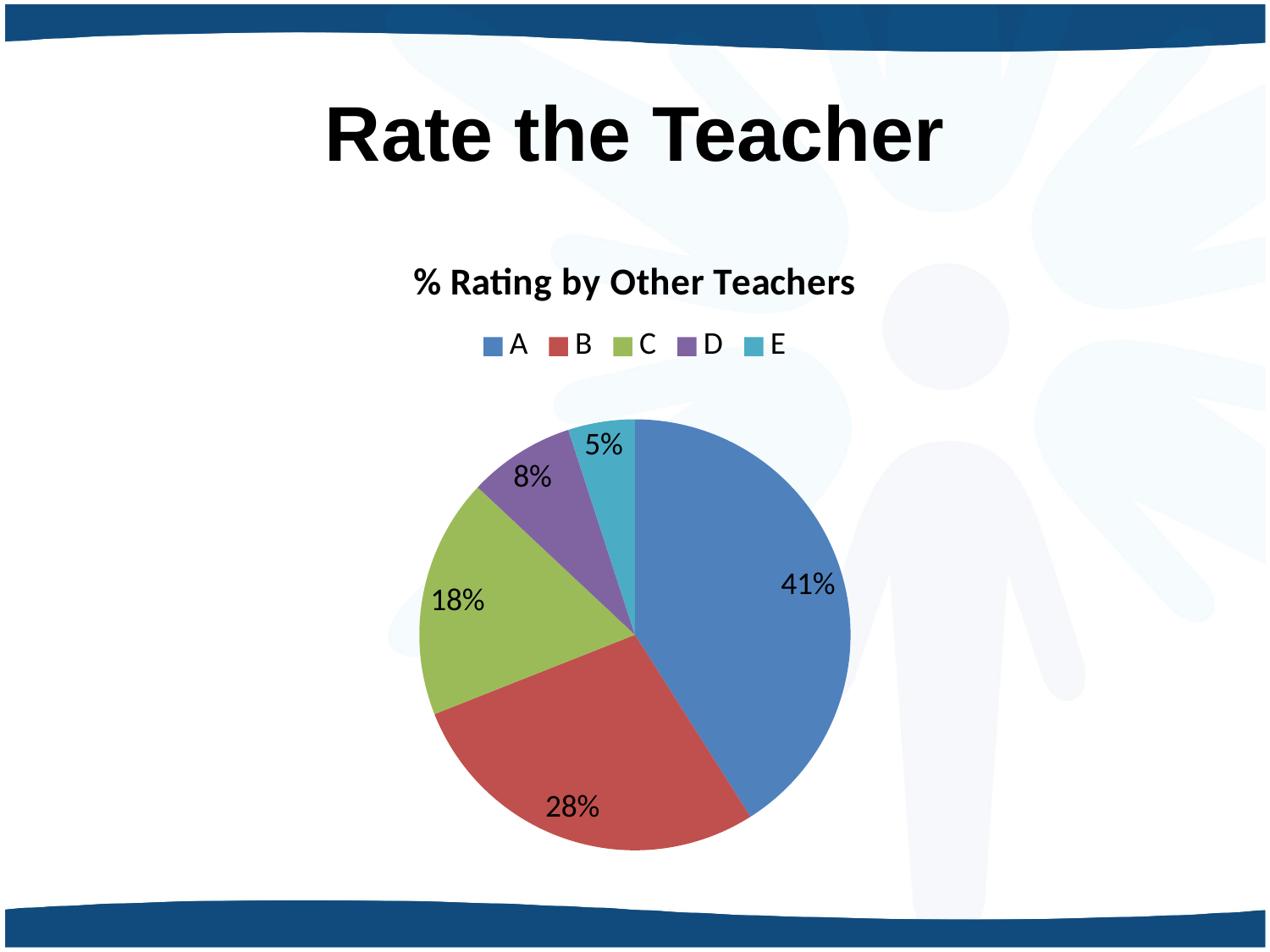
What percentage of the pie is rating D? 8% Which rating has the largest share of the pie? A What type of chart is shown on the slide? pie chart Which rating has the smallest share of the pie? E What is the difference in percentage points between rating A and rating B? 13 What percentage of the pie is rating C? 18% Which is larger, the share for rating C or the share for rating D? C How many slices does the pie chart have? 5 What percentage of the pie is rating E? 5% What percentage of the pie is rating B? 28% What is the title of the chart? % Rating by Other Teachers What percentage of the pie is rating A? 41%